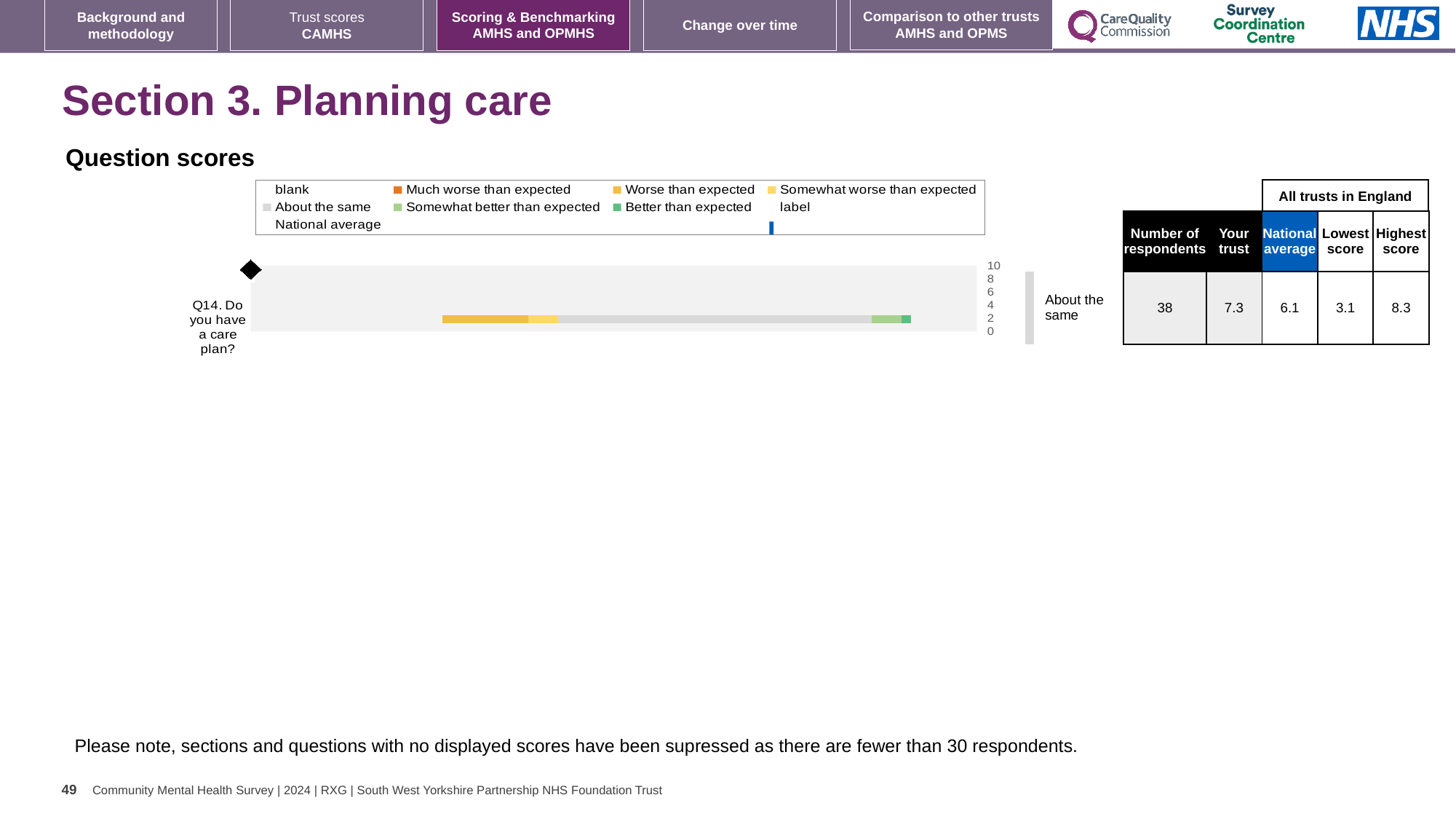
What kind of chart is used to show the Q14 question score? Bar chart Which question is plotted in the Question scores chart? Q14. Do you have a care plan? For Q14, what is the difference between the highest score and the lowest score among all trusts in England? 5.2 In the table beside the chart, what is the highest score among all trusts in England for Q14? 8.3 For Q14, what is the difference between the 'Your trust' score and the national average? 1.2 In the table beside the chart, what is the 'Your trust' score for Q14? 7.3 For Q14, which is larger: the 'Your trust' score or the national average? Your trust In the table beside the chart, what is the number of respondents for Q14? 38 What benchmark category label is shown to the right of the Q14 bar? About the same How many questions are plotted in the Question scores chart? 1 In the table beside the chart, what is the lowest score among all trusts in England for Q14? 3.1 In the table beside the chart, what is the national average score for Q14? 6.1